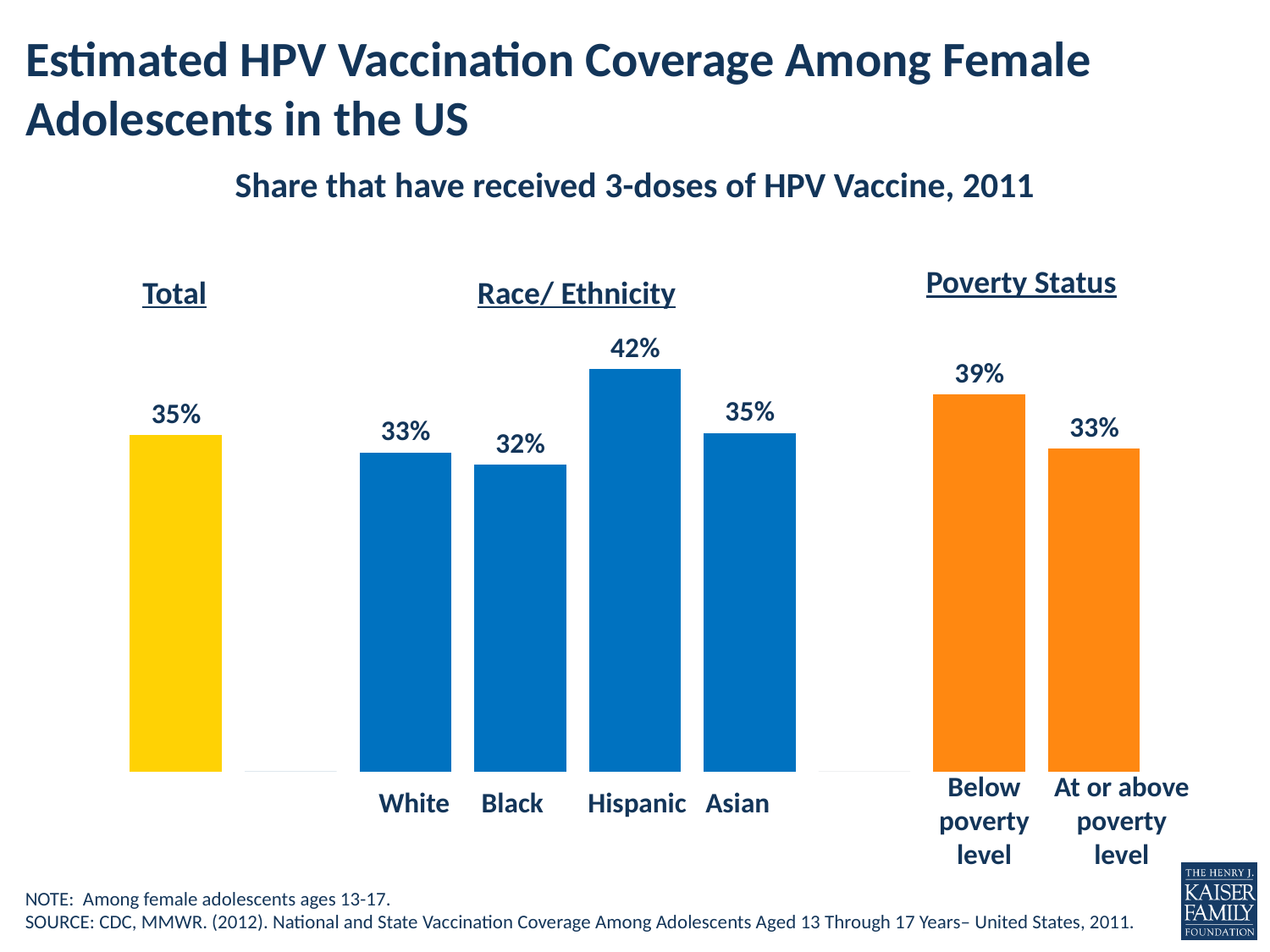
Which race/ethnicity group has the lowest HPV vaccination coverage? Black What is the value shown for Black female adolescents? 32% What type of chart is shown on the slide? Bar chart Which has higher coverage, Below poverty level or At or above poverty level? Below poverty level How many race/ethnicity groups are shown in the chart? 4 What is the difference in coverage between those below the poverty level and those at or above the poverty level? 6 percentage points What is the difference in coverage between Hispanic and White female adolescents? 9 percentage points What share of female adolescents below the poverty level had received 3 doses of HPV vaccine? 39% What share of Hispanic female adolescents had received 3 doses of HPV vaccine in 2011? 42% Which race/ethnicity group has the highest HPV vaccination coverage? Hispanic What is the value shown for the Total bar? 35% What colour are the bars in the Poverty Status group? Orange